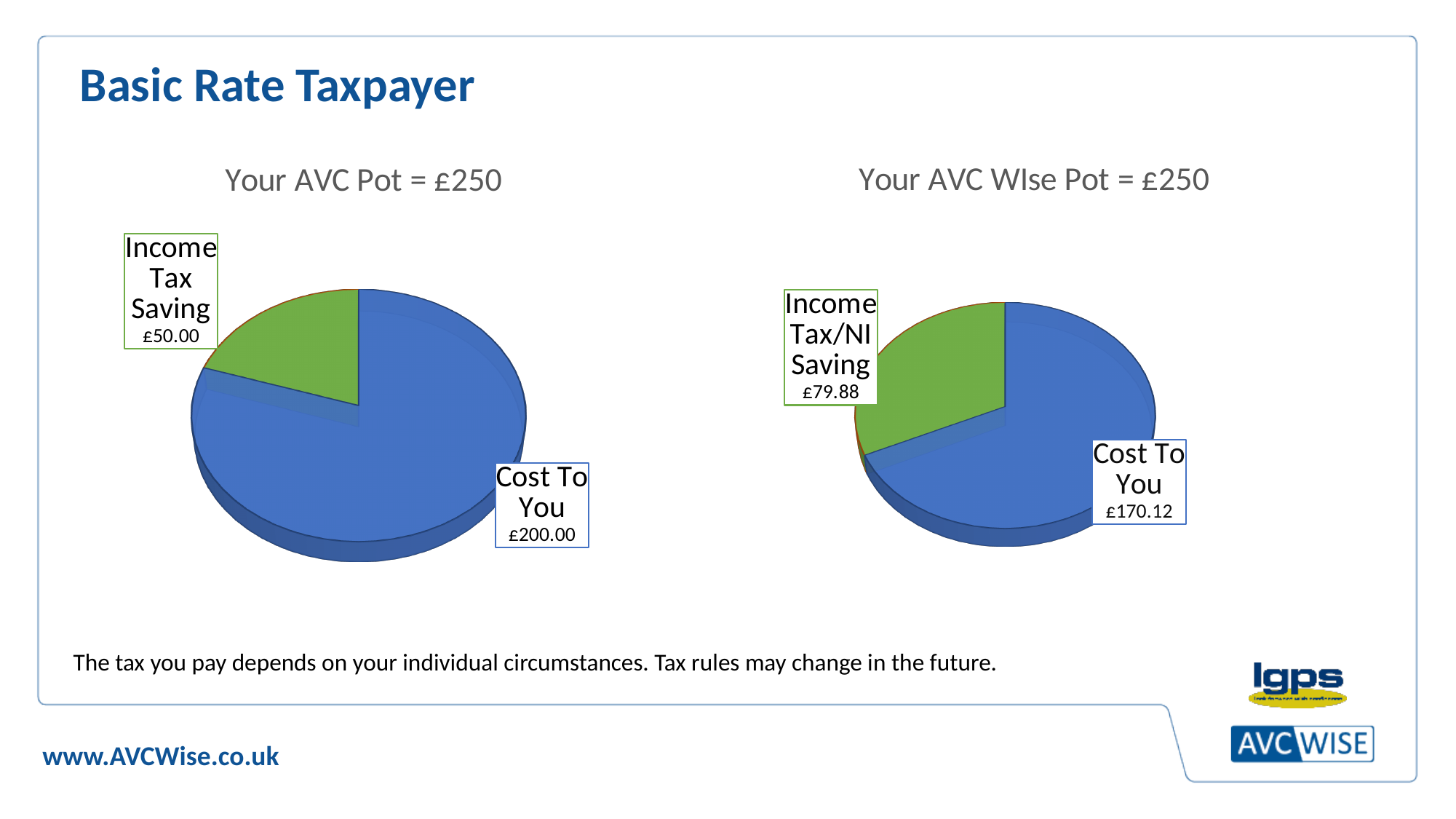
In the chart titled "Your AVC WIse Pot = £250", what is the value for Income Tax/NI Saving? £79.88 In the chart titled "Your AVC Pot = £250", what is the value for Income Tax Saving? £50.00 In the chart titled "Your AVC WIse Pot = £250", what is the value for Cost To You? £170.12 In the chart titled "Your AVC WIse Pot = £250", what is the difference between Cost To You and Income Tax/NI Saving? £90.24 In the right chart, which slice is the smallest? Income Tax/NI Saving Is the Cost To You larger in the left chart or the right chart? Left chart In the left chart, what share of the pie is Income Tax Saving? 20% In the chart titled "Your AVC Pot = £250", what is the difference between Cost To You and Income Tax Saving? £150.00 How many slices does the right chart have? 2 What type of chart is used on this slide? Pie chart In the chart titled "Your AVC Pot = £250", what is the value for Cost To You? £200.00 In the left chart, which slice is the largest? Cost To You